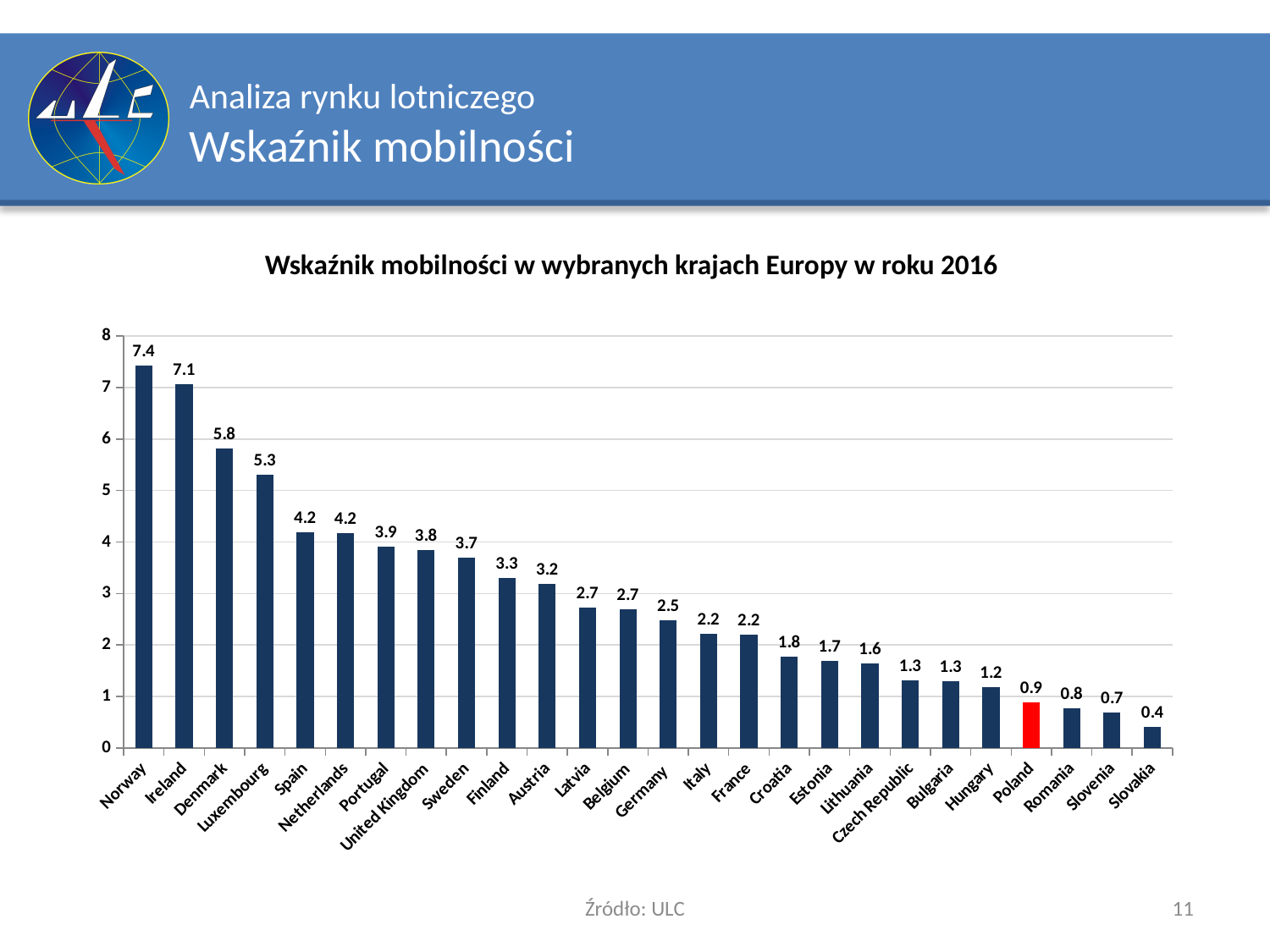
Which has a higher value, Sweden or Finland? Sweden What is the difference between the values for Norway and Ireland? 0.3 What is the value shown for Luxembourg? 5.3 What is the value shown for Germany? 2.5 Is the value for Denmark greater or less than 5? greater Which country has the highest mobility index? Norway Which country has the lowest mobility index? Slovakia Which country's bar is coloured red instead of dark blue? Poland How many countries are shown in the chart? 26 What type of chart is shown on the slide? Bar chart What is the mobility index value for Poland? 0.9 What is the difference between the values for Poland and Hungary? 0.3